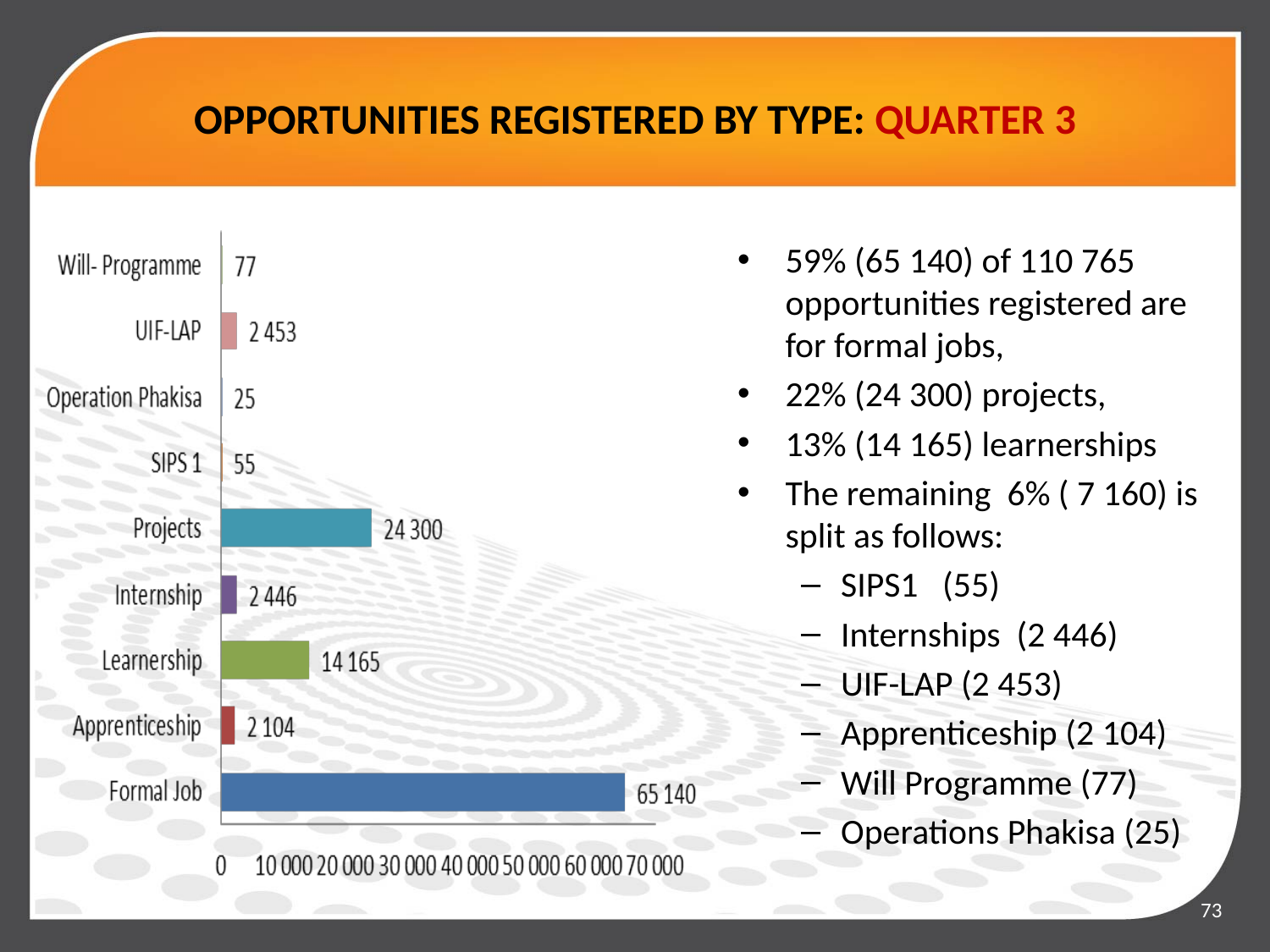
What is the difference between the values for Projects and Learnership? 10 135 Which is larger, the value for UIF-LAP or the value for Internship? UIF-LAP Which category has the lowest value? Operation Phakisa Is the value for Projects greater or less than 20 000? greater What is the value for Formal Job? 65 140 What kind of chart is shown on the slide? bar chart What is the value for Learnership? 14 165 What is the title of the slide containing the chart? OPPORTUNITIES REGISTERED BY TYPE: QUARTER 3 Which category has the highest value? Formal Job How many categories are shown in the chart? 9 What is the difference between the values for Formal Job and Projects? 40 840 What is the value for Operation Phakisa? 25